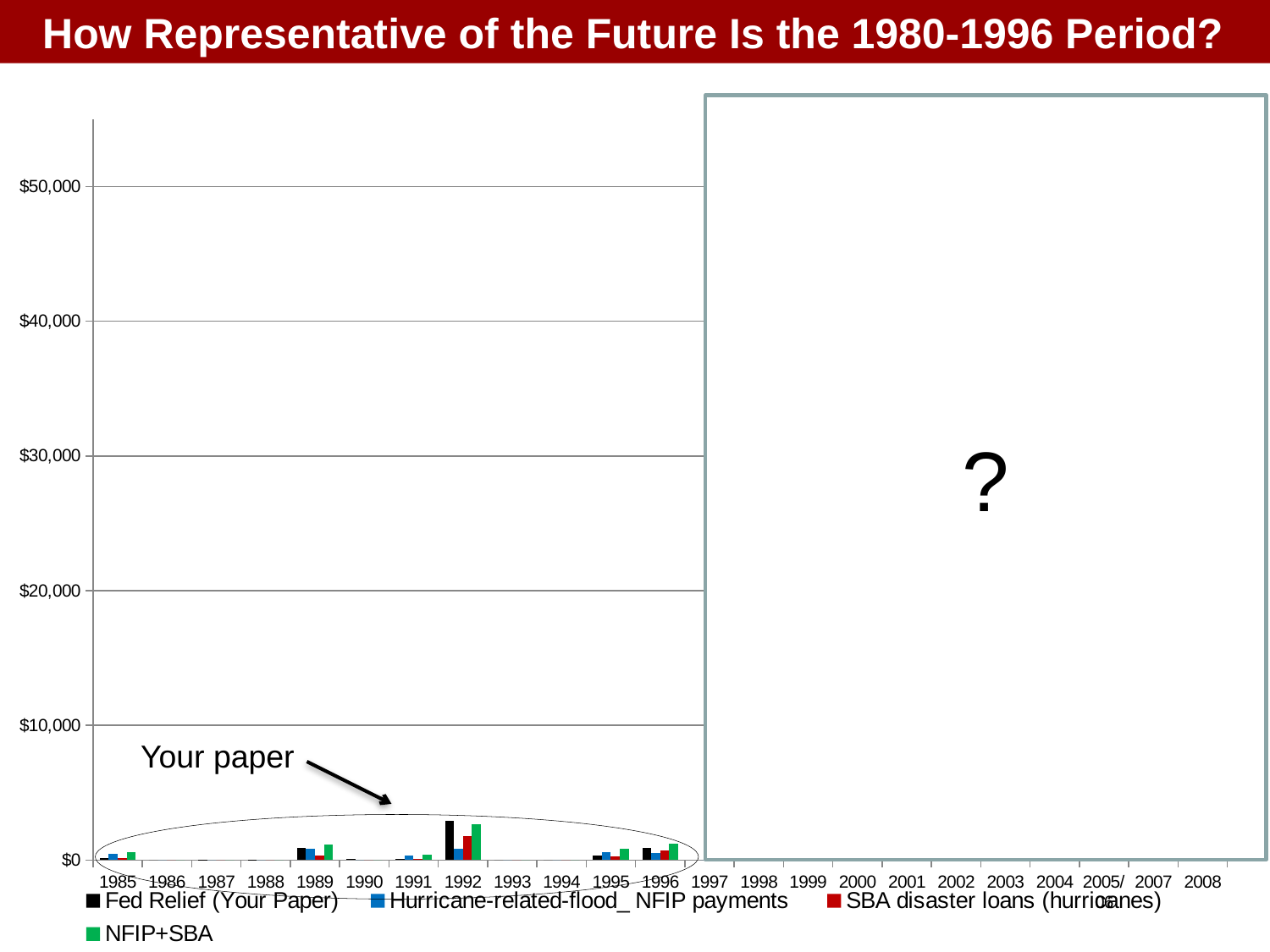
Is the NFIP+SBA value for 1992 greater or less than $10,000? less In which year is the Fed Relief (Your Paper) bar tallest? 1992 Which colour represents the NFIP+SBA series in the legend? green In 1992, which is larger, the Fed Relief (Your Paper) bar or the SBA disaster loans (hurricanes) bar? Fed Relief (Your Paper) Which is larger, the Fed Relief (Your Paper) value for 1992 or for 1989? 1992 How many series does the legend list? 4 In which year is the NFIP+SBA bar tallest? 1992 What kind of chart is shown on the slide? bar chart Is the Fed Relief (Your Paper) value for 1989 greater or less than $10,000? less What is the title of the slide? How Representative of the Future Is the 1980-1996 Period? Which is larger, the NFIP+SBA value for 1992 or for 1996? 1992 Is the Fed Relief (Your Paper) value for 1992 greater or less than $10,000? less